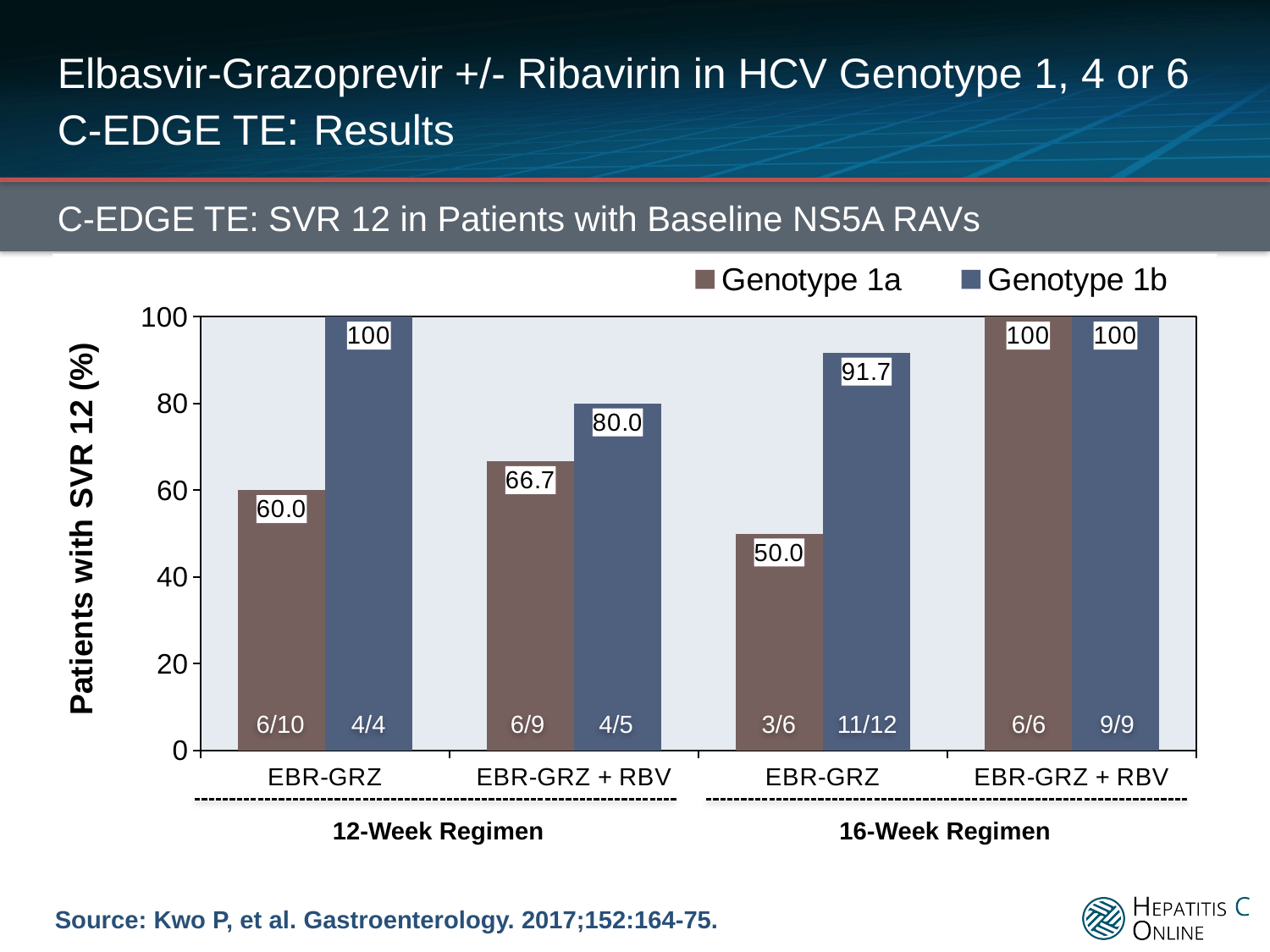
What kind of chart is shown on the slide? Bar chart How many patients achieved SVR 12 out of the total for Genotype 1b in the 16-week EBR-GRZ group, as labeled on the bar? 11/12 What is the difference between the Genotype 1b and Genotype 1a SVR 12 rates in the 16-week EBR-GRZ group? 41.7 What is the SVR 12 rate for Genotype 1a in the 12-week EBR-GRZ group? 60.0 What is the SVR 12 rate for Genotype 1b in the 16-week EBR-GRZ group? 91.7 Which regimen group has the lowest SVR 12 rate for Genotype 1a? EBR-GRZ (16-Week Regimen) How many regimen groups are shown on the x axis? 4 In the 12-week EBR-GRZ + RBV group, which genotype has the higher SVR 12 rate? Genotype 1b What is the label of the y axis? Patients with SVR 12 (%) How many series does the legend list? 2 What is the SVR 12 rate for Genotype 1b in the 12-week EBR-GRZ + RBV group? 80.0 What is the difference between the Genotype 1b and Genotype 1a SVR 12 rates in the 12-week EBR-GRZ group? 40.0